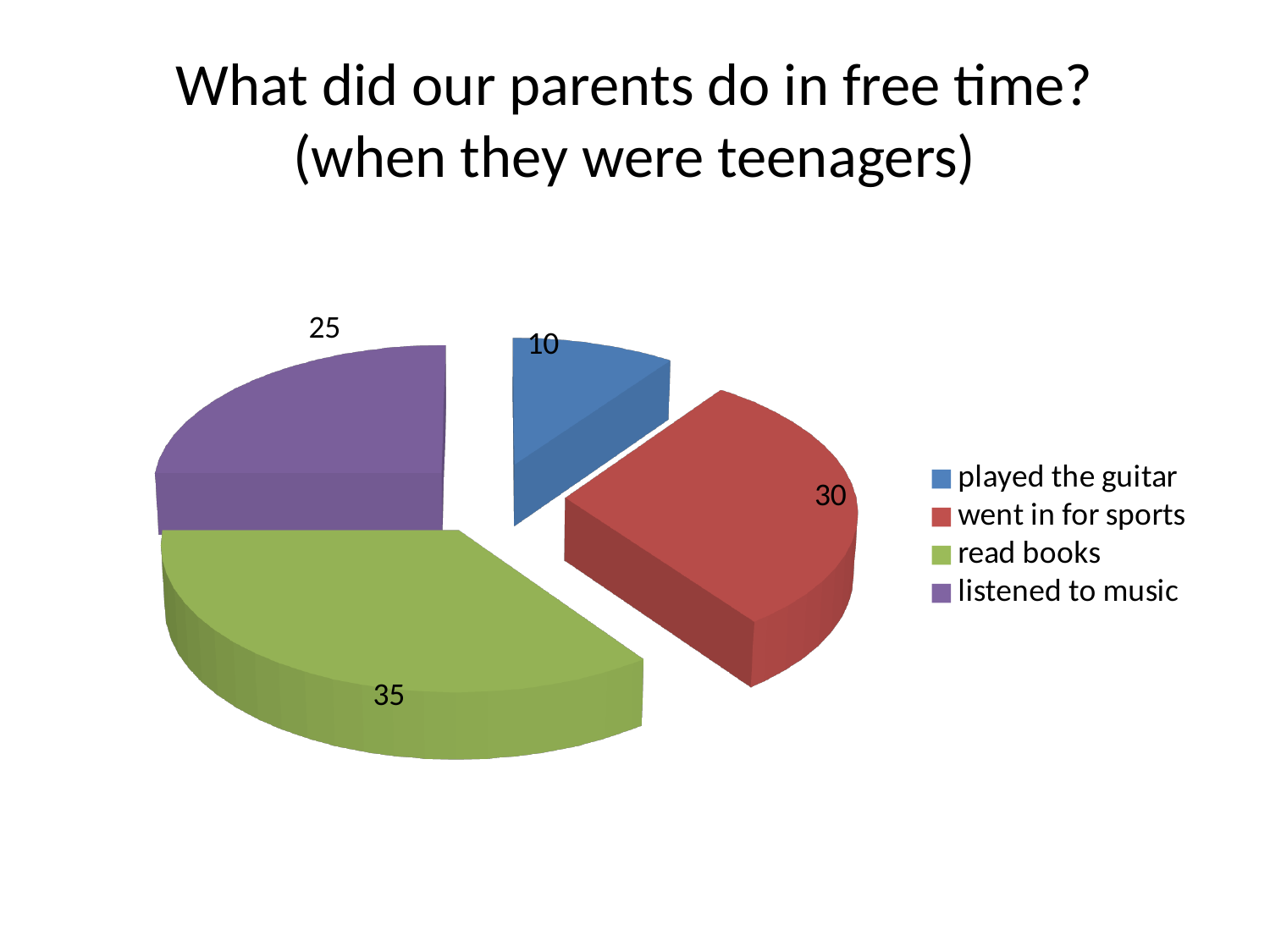
Which category has the smallest slice? played the guitar What value is shown for 'listened to music'? 25 How many categories does the pie chart show? 4 What share of the pie does 'read books' represent? 35% Which category has the largest slice? read books What value is shown for 'went in for sports'? 30 What kind of chart is shown on the slide? pie chart What is the difference between the values for 'read books' and 'played the guitar'? 25 What colour is the 'listened to music' slice? purple What value is shown for 'read books'? 35 Which is larger, 'went in for sports' or 'listened to music'? went in for sports What value is shown for 'played the guitar'? 10